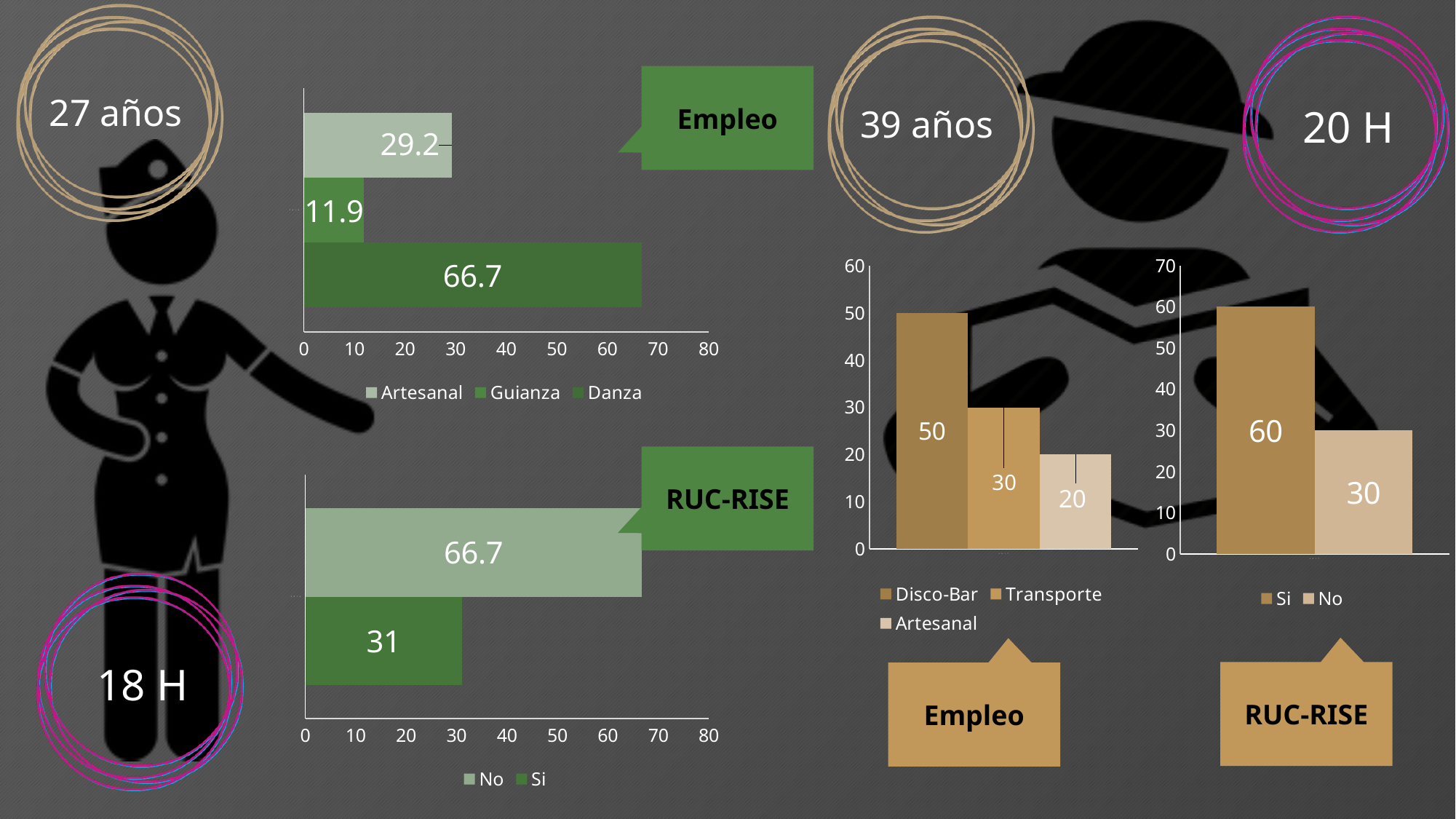
In the green Empleo bar chart on the left side of the slide, what is the difference between the values for Artesanal and Guianza? 17.3 In the green RUC-RISE bar chart on the left side of the slide, which is larger, No or Si? No In the brown Empleo bar chart on the right side of the slide, which category has the lowest value? Artesanal In the green Empleo bar chart on the left side of the slide, which category has the highest value? Danza What kind of chart is the green RUC-RISE chart on the left side of the slide? Bar chart In the green RUC-RISE bar chart on the left side of the slide, what is the value for No? 66.7 In the brown Empleo bar chart on the right side of the slide, what is the value for Disco-Bar? 50 In the brown RUC-RISE bar chart on the right side of the slide, what is the value for Si? 60 In the green Empleo bar chart on the left side of the slide, what is the value for Guianza? 11.9 In the green Empleo bar chart on the left side of the slide, what is the value for Danza? 66.7 In the brown Empleo bar chart on the right side of the slide, how many categories does the legend list? 3 In the brown RUC-RISE bar chart on the right side of the slide, what is the difference between Si and No? 30